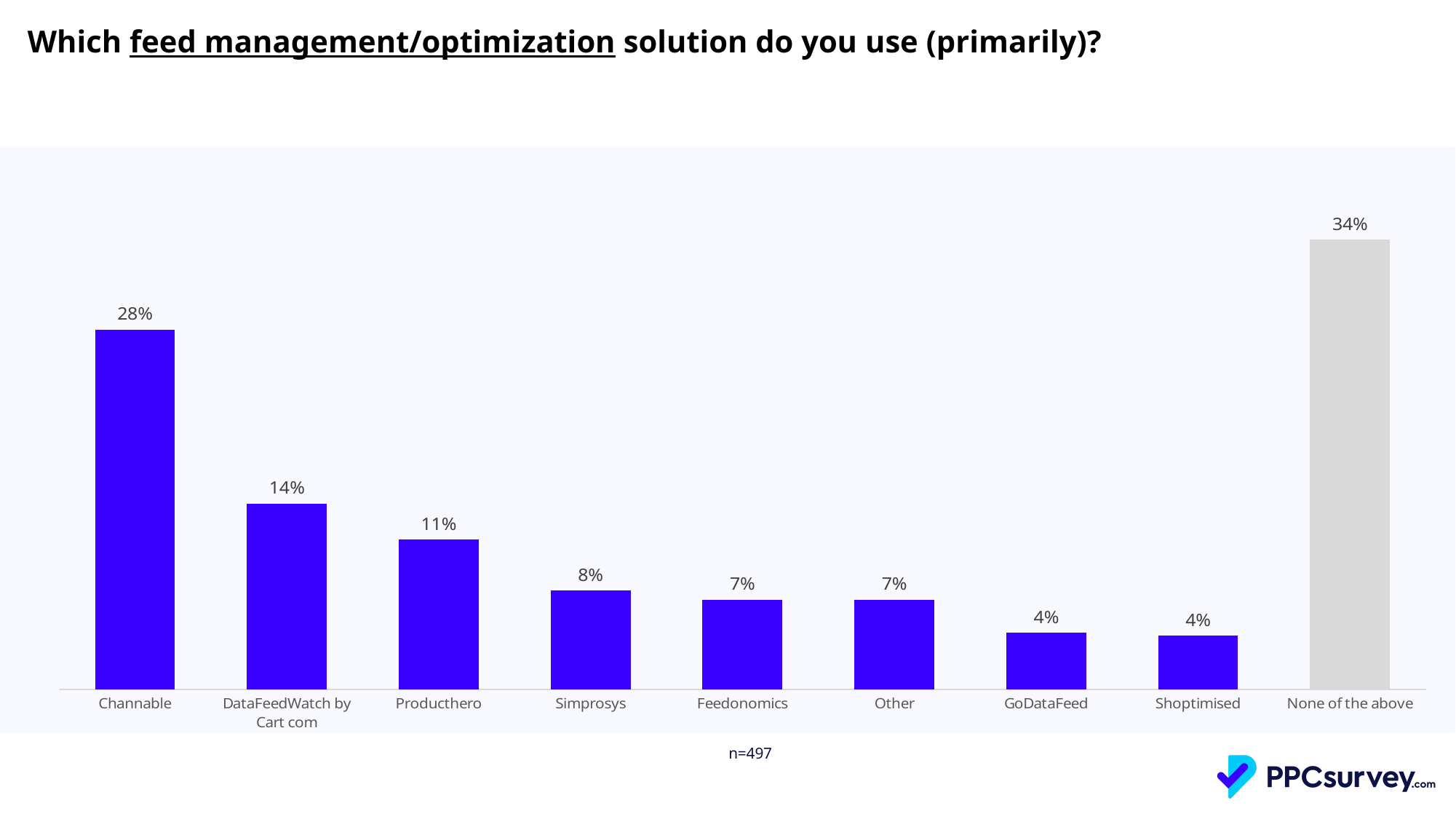
What is the sample size (n) stated below the chart? n=497 What percentage of respondents use Channable as their primary feed management solution? 28% What is the value shown for Producthero? 11% Which bar is coloured grey rather than blue? None of the above What is the difference between the values for Channable and DataFeedWatch by Cart com? 14% How many categories are shown on the x axis? 9 What percentage is shown for None of the above? 34% Which is larger, the value for Simprosys or the value for Feedonomics? Simprosys What is the value shown for GoDataFeed? 4% Which category has the highest value on the chart? None of the above What kind of chart is shown on the slide? Bar chart Which named feed management solution has the highest share of respondents? Channable